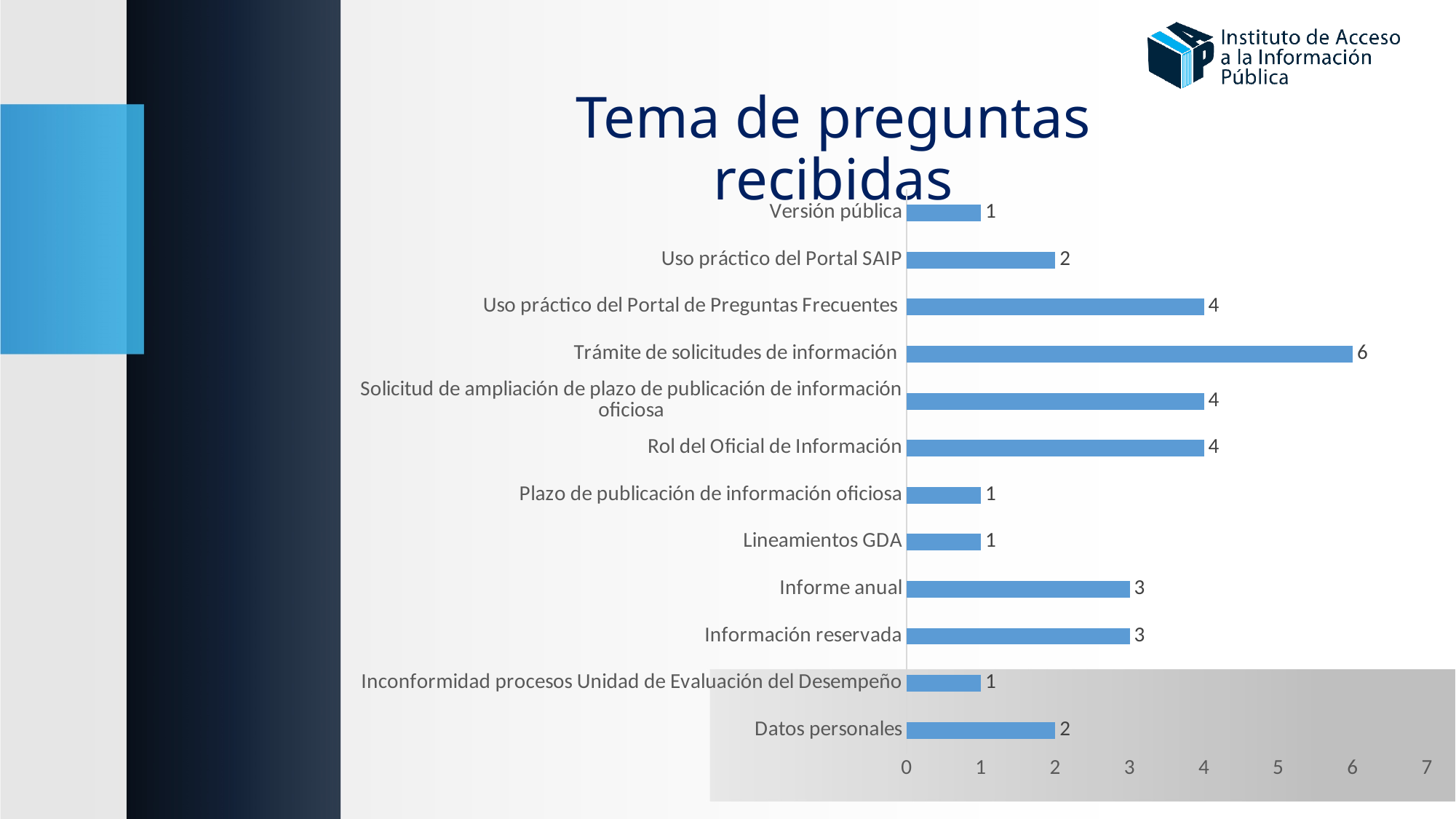
Which category has the highest value? Trámite de solicitudes de información What is the value for Lineamientos GDA? 1 What is the difference between Uso práctico del Portal de Preguntas Frecuentes and Versión pública? 3 What kind of chart is shown on the slide? Bar chart What is the value for Informe anual? 3 How many categories are shown in the chart? 12 What is the title of the chart? Tema de preguntas recibidas What is the difference between Trámite de solicitudes de información and Rol del Oficial de Información? 2 Which is larger, Información reservada or Datos personales? Información reservada What is the value for Trámite de solicitudes de información? 6 What is the value for Uso práctico del Portal SAIP? 2 What is the highest value shown on the x axis? 7